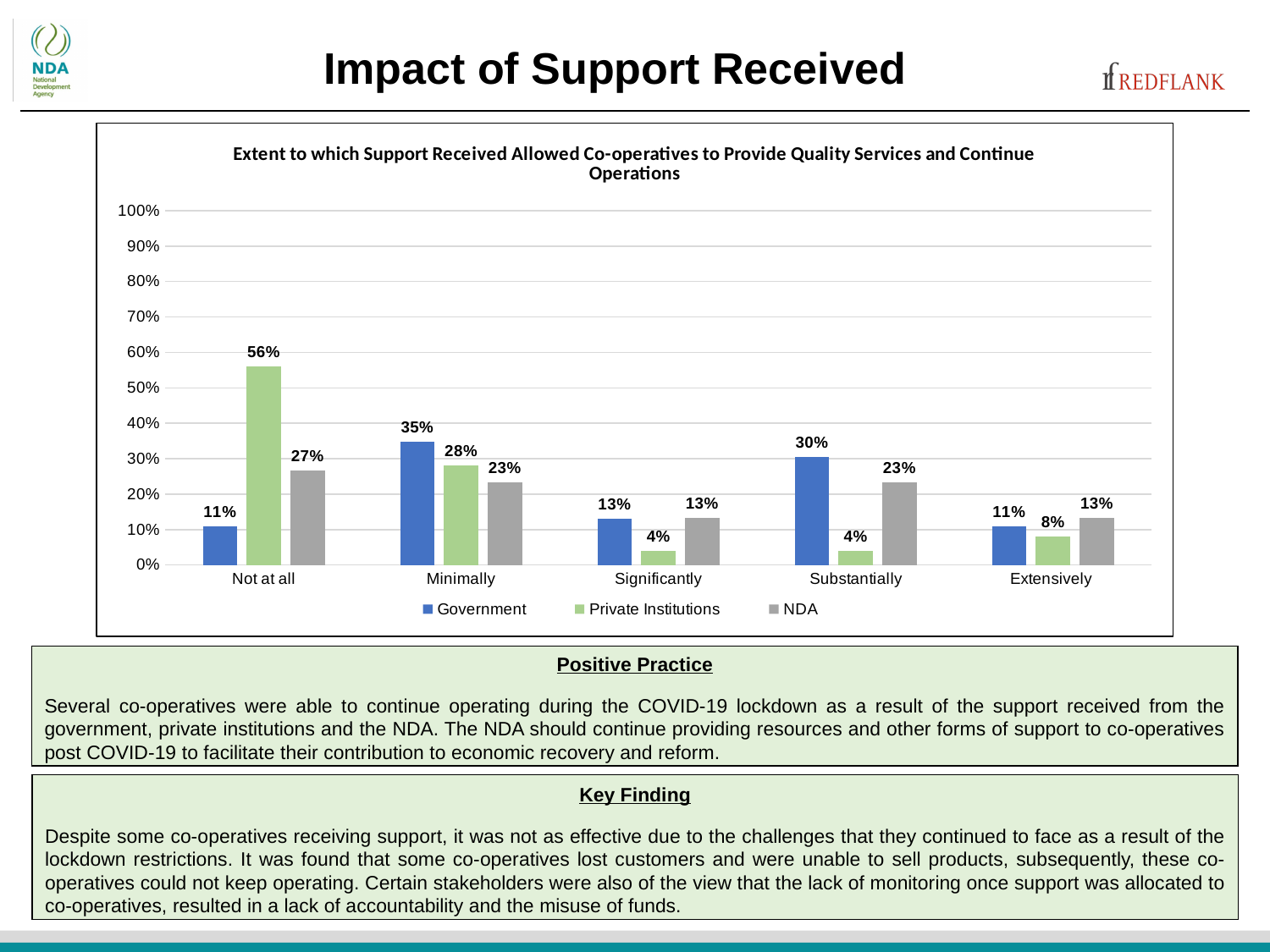
What type of chart is shown on the slide? Bar chart What is the Government value for the "Minimally" category? 35% For the "Substantially" category, which is larger: the Government value or the NDA value? Government Which category has the lowest NDA value? Significantly and Extensively (both 13%) Which series is shown in green in the legend? Private Institutions How many categories are shown on the x axis? 5 How many series does the legend list? 3 What percentage of Private Institutions support is rated "Not at all"? 56% What is the Private Institutions value for "Extensively"? 8% What is the NDA value for the "Substantially" category? 23% What is the difference between the Private Institutions and Government values for "Not at all"? 45% Which category has the highest Government value? Minimally